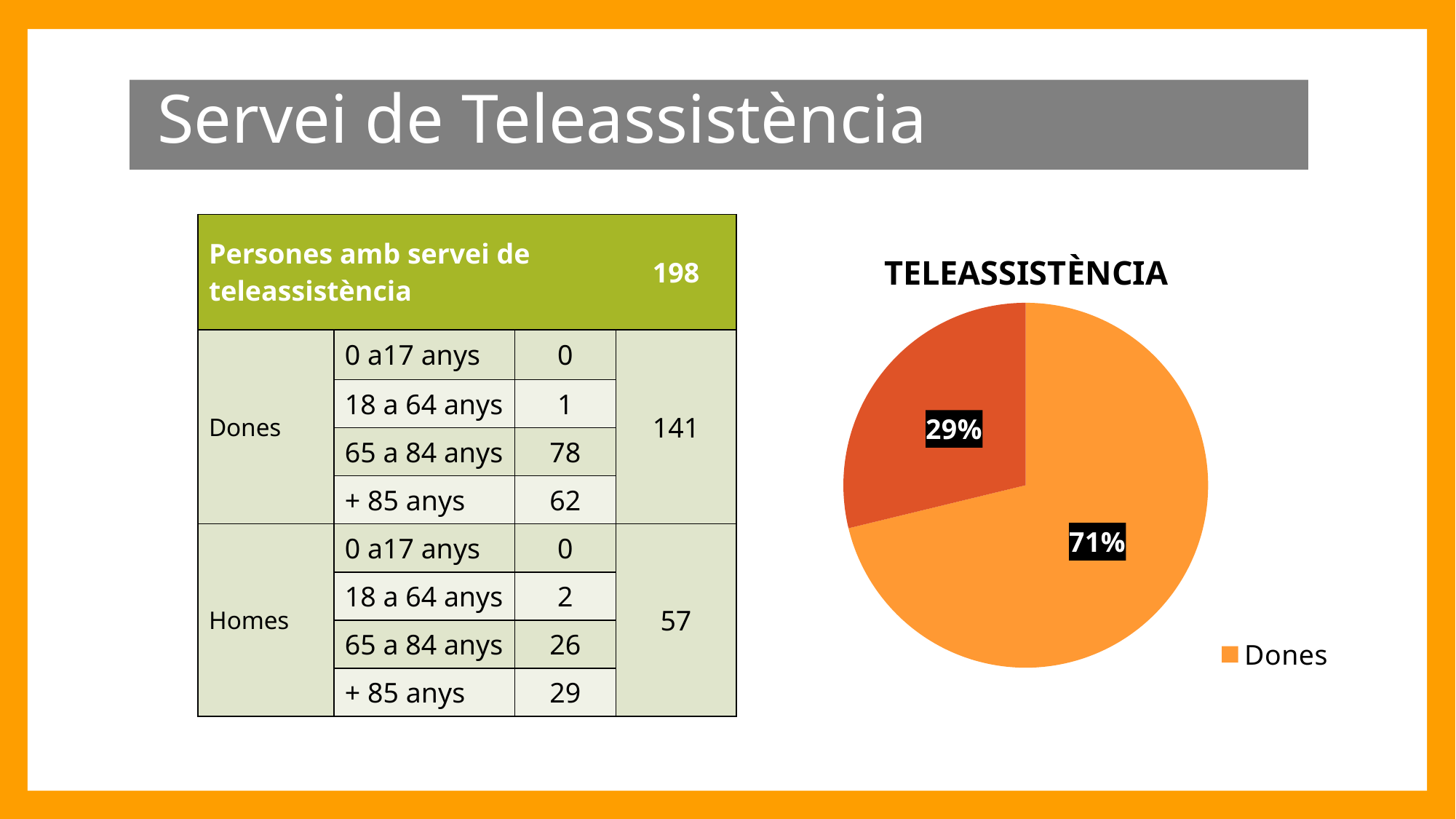
Is the Dones slice larger or smaller than the other slice in the pie chart? larger How many slices does the pie chart have? 2 Is the share of the Dones slice greater or less than 50%? greater What share of the pie chart does the Dones slice represent? 71% Which entry appears in the pie chart's legend? Dones What is the percentage of the smallest slice in the pie chart? 29% What percentage is shown on the smaller, darker slice of the pie chart? 29% What is the title of the pie chart? TELEASSISTÈNCIA How many entries does the pie chart's legend list? 1 What kind of chart is shown on the slide? pie chart What is the difference in percentage points between the 71% slice and the 29% slice? 42 Which slice of the pie chart is the largest? Dones (71%)